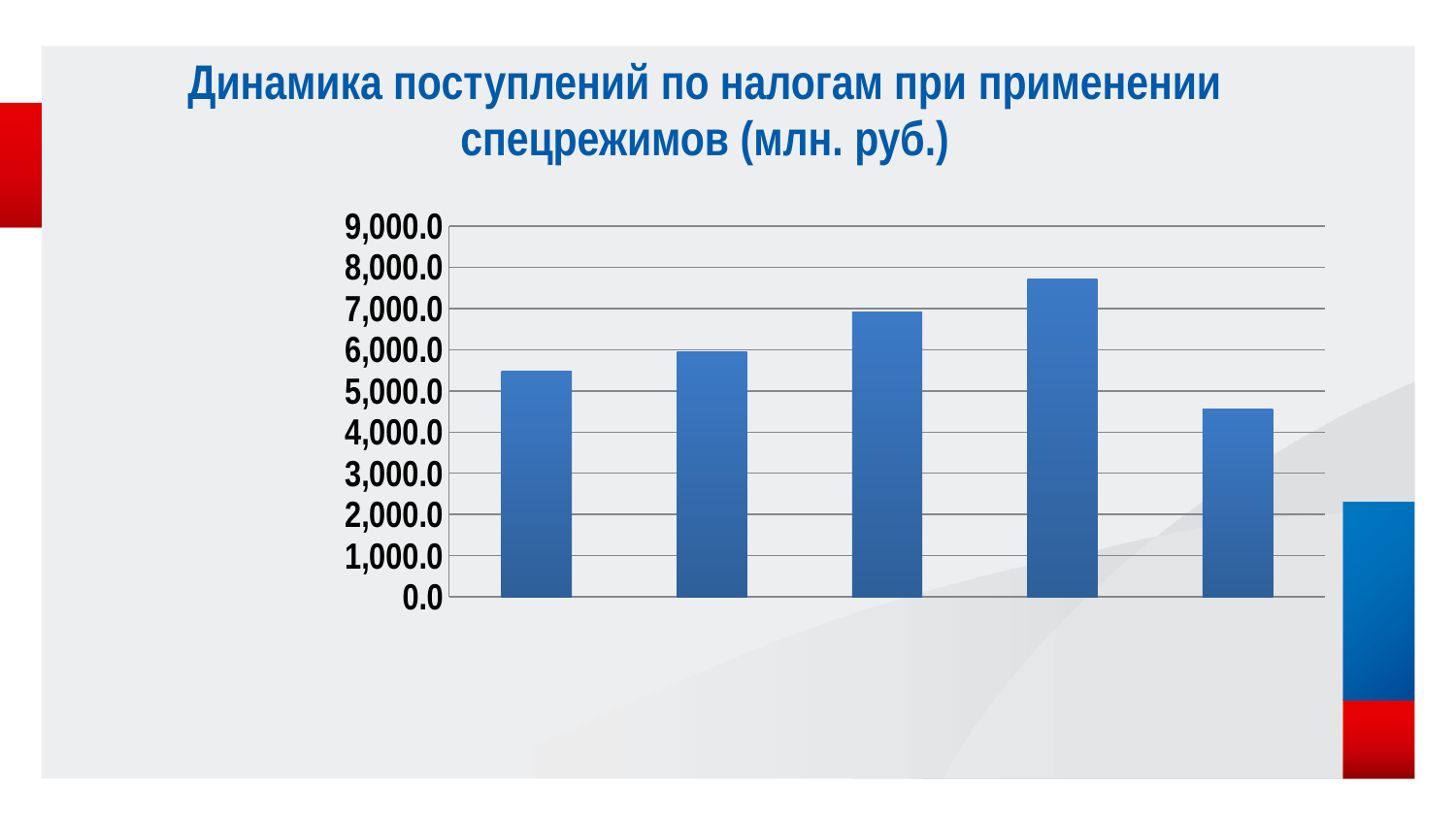
Is the value of the fourth bar greater or less than 8,000.0? less What is the title of the chart? Динамика поступлений по налогам при применении спецрежимов (млн. руб.) Which bar is the lowest in the chart? the fifth bar Is the value of the first bar greater or less than 5,000.0? greater Which bar is the highest in the chart? the fourth bar Is the value of the fifth bar greater or less than 5,000.0? less Do the values rise or fall from the first bar to the fourth bar? rise How many bars are plotted in the chart? 5 What kind of chart is shown on the slide? bar chart Which is larger, the first bar or the second bar? the second bar